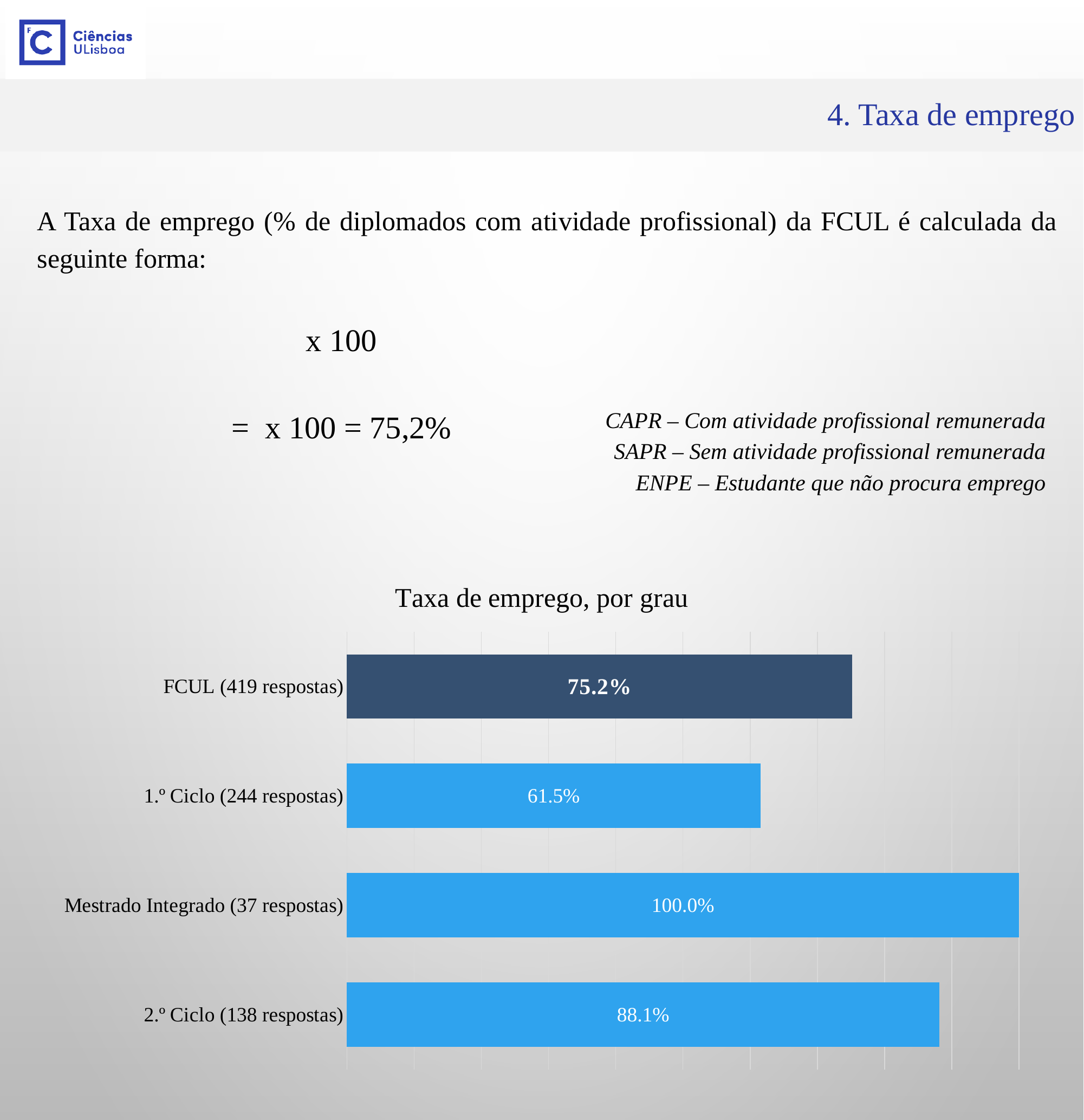
What is the value for 1.º Ciclo (244 respostas)? 61.5% What is the value for 2.º Ciclo (138 respostas)? 88.1% What is the value for Mestrado Integrado (37 respostas)? 100.0% What kind of chart is shown on the slide? Bar chart What is the value for FCUL (419 respostas) in the chart? 75.2% What is the title of the chart? Taxa de emprego, por grau Which category has the lowest value in the chart? 1.º Ciclo (244 respostas) What is the difference between the values for Mestrado Integrado and FCUL? 24.8% Which is larger, the value for 2.º Ciclo or the value for FCUL? 2.º Ciclo What is the difference between the values for 2.º Ciclo and 1.º Ciclo? 26.6% Which category has the highest value in the chart? Mestrado Integrado (37 respostas) How many categories are shown in the chart? 4